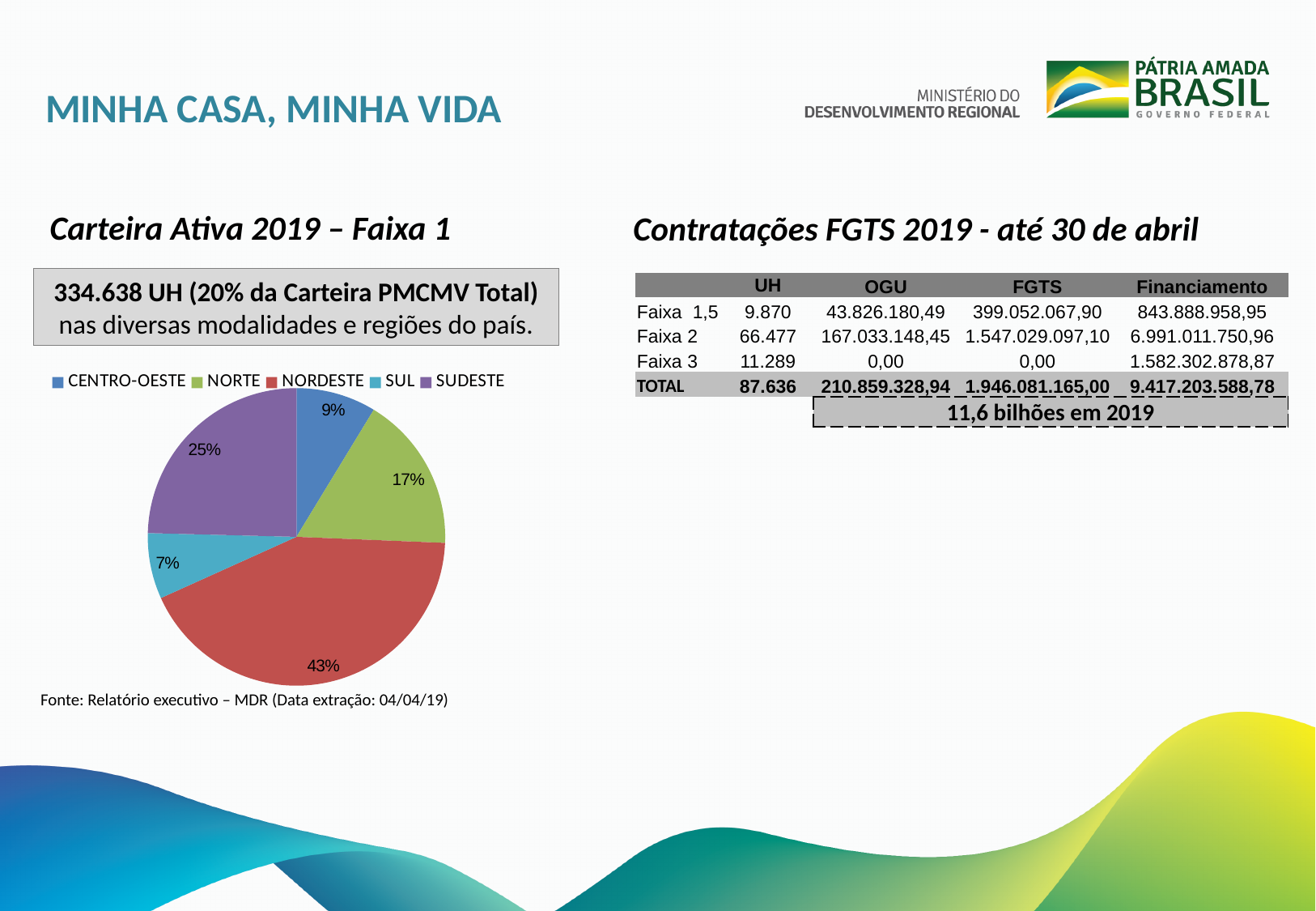
How many regions are shown in the pie chart? 5 What kind of chart is shown on the slide? pie chart Which colour represents SUDESTE in the pie chart? purple What share of the pie does CENTRO-OESTE represent? 9% What share of the pie does NORTE represent? 17% What share of the pie does NORDESTE represent? 43% What is the difference in percentage points between the NORDESTE and SUDESTE slices? 18 Which region has the largest slice of the pie? NORDESTE Which region has the smallest slice of the pie? SUL Which slice is larger, NORTE or CENTRO-OESTE? NORTE